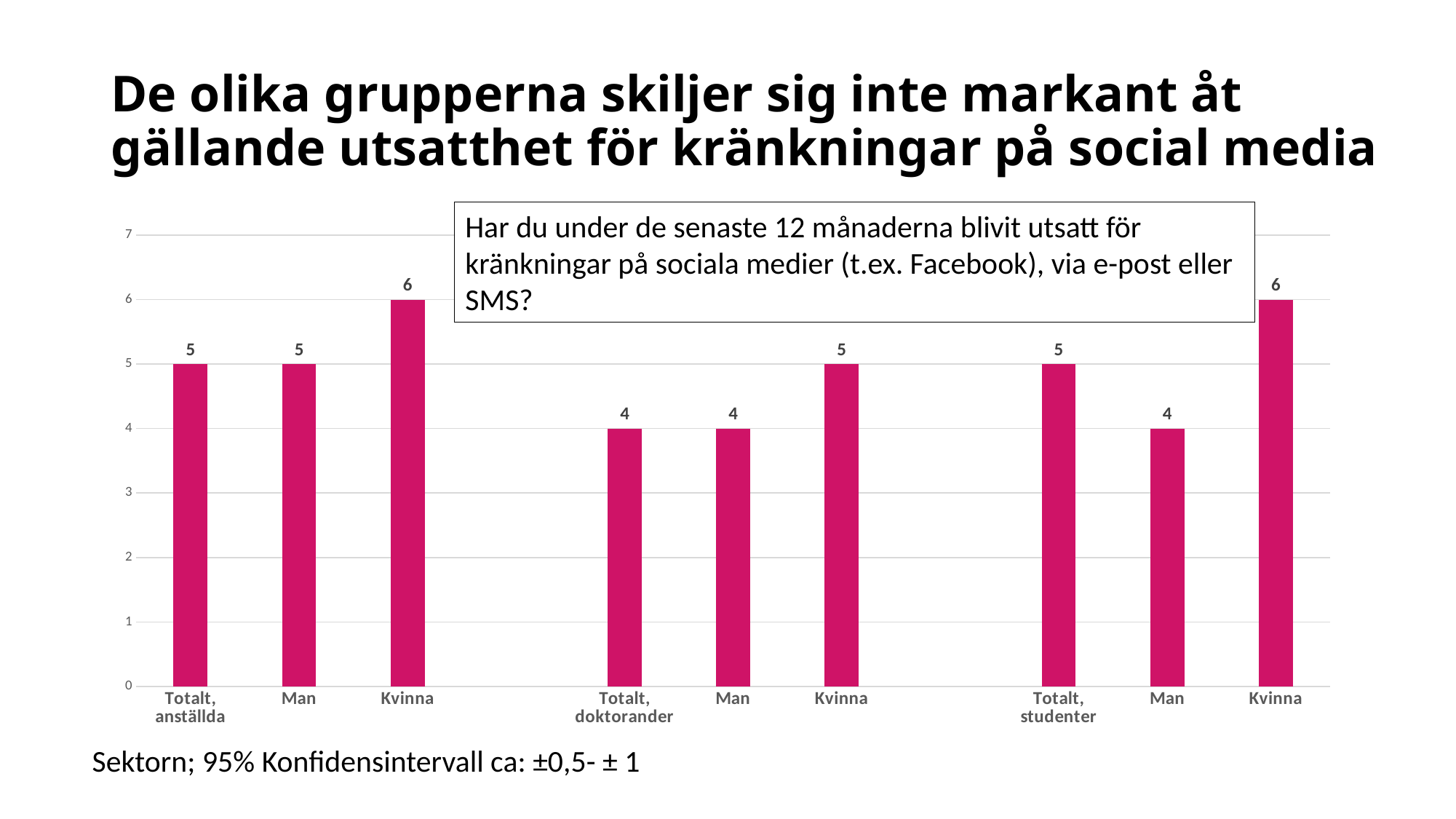
What kind of chart is shown on the slide? Bar chart What colour are the bars in the chart? Pink/magenta Which is larger: Kvinna in the doktorander group or Kvinna in the anställda group? Kvinna in the anställda group Within the studenter group, which category has the lowest value? Man What is the value for Totalt, doktorander? 4 What is the value for Man in the studenter group? 4 What is the value for Totalt, anställda? 5 How many bars are plotted in the chart? 9 Within the doktorander group, which category has the highest value? Kvinna What is the difference between Kvinna and Man in the studenter group? 2 What is the value for Kvinna in the anställda group? 6 What is the highest value shown on the vertical axis? 7